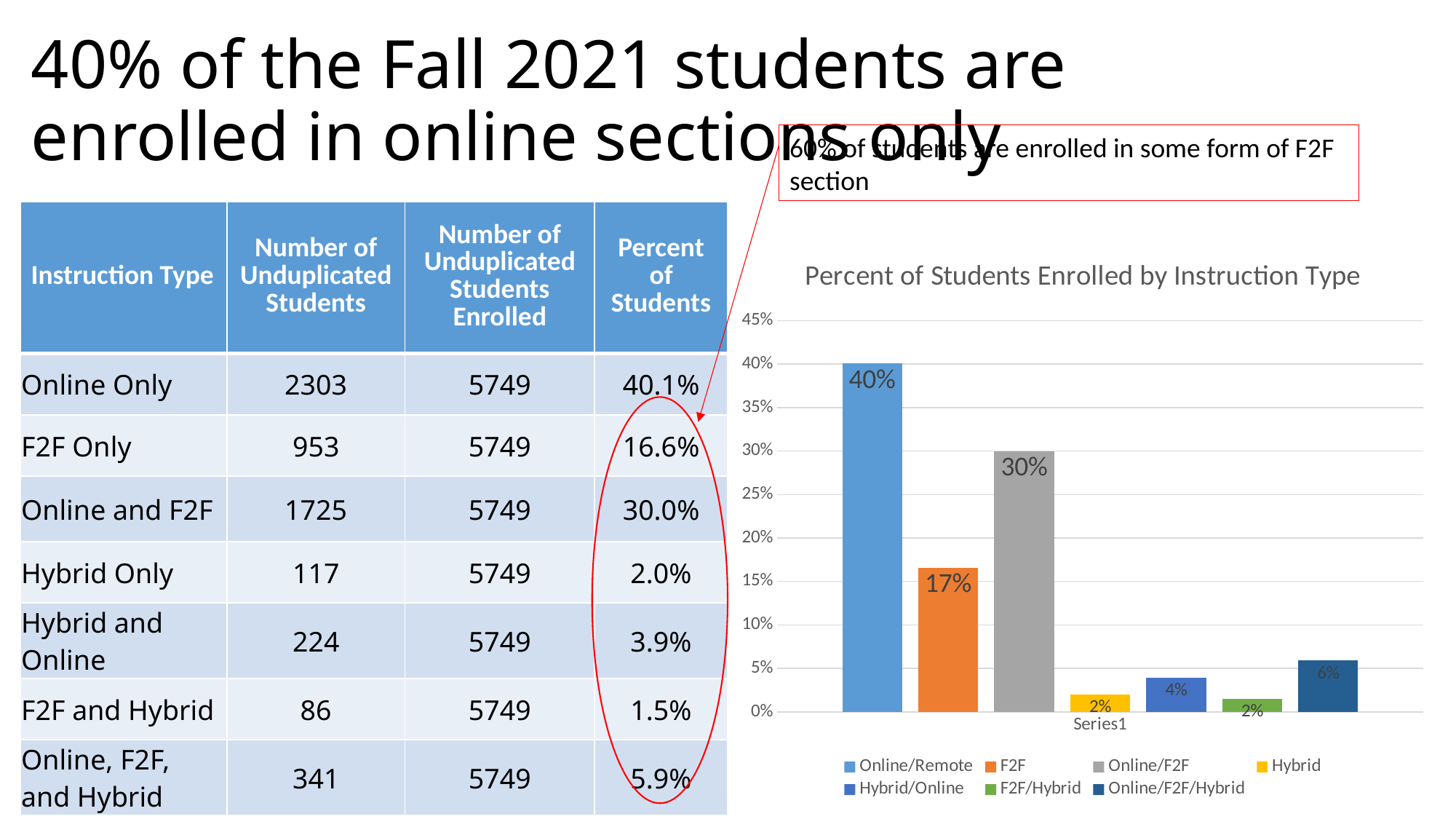
How many series does the chart legend list? 7 What type of chart is shown on the slide? bar chart What is the difference between the Online/Remote value and the Online/F2F value in the chart? 10% What is the value shown for Hybrid/Online in the chart? 4% What is the title of the chart? Percent of Students Enrolled by Instruction Type What is the value shown for Online/F2F in the chart? 30% Is the value for Online/Remote greater or less than 35%? greater What is the value shown for F2F in the chart? 17% What is the value shown for Online/Remote in the chart? 40% Which series has the highest value in the chart? Online/Remote What is the value shown for Online/F2F/Hybrid in the chart? 6% Which is larger in the chart, F2F or Online/F2F? Online/F2F